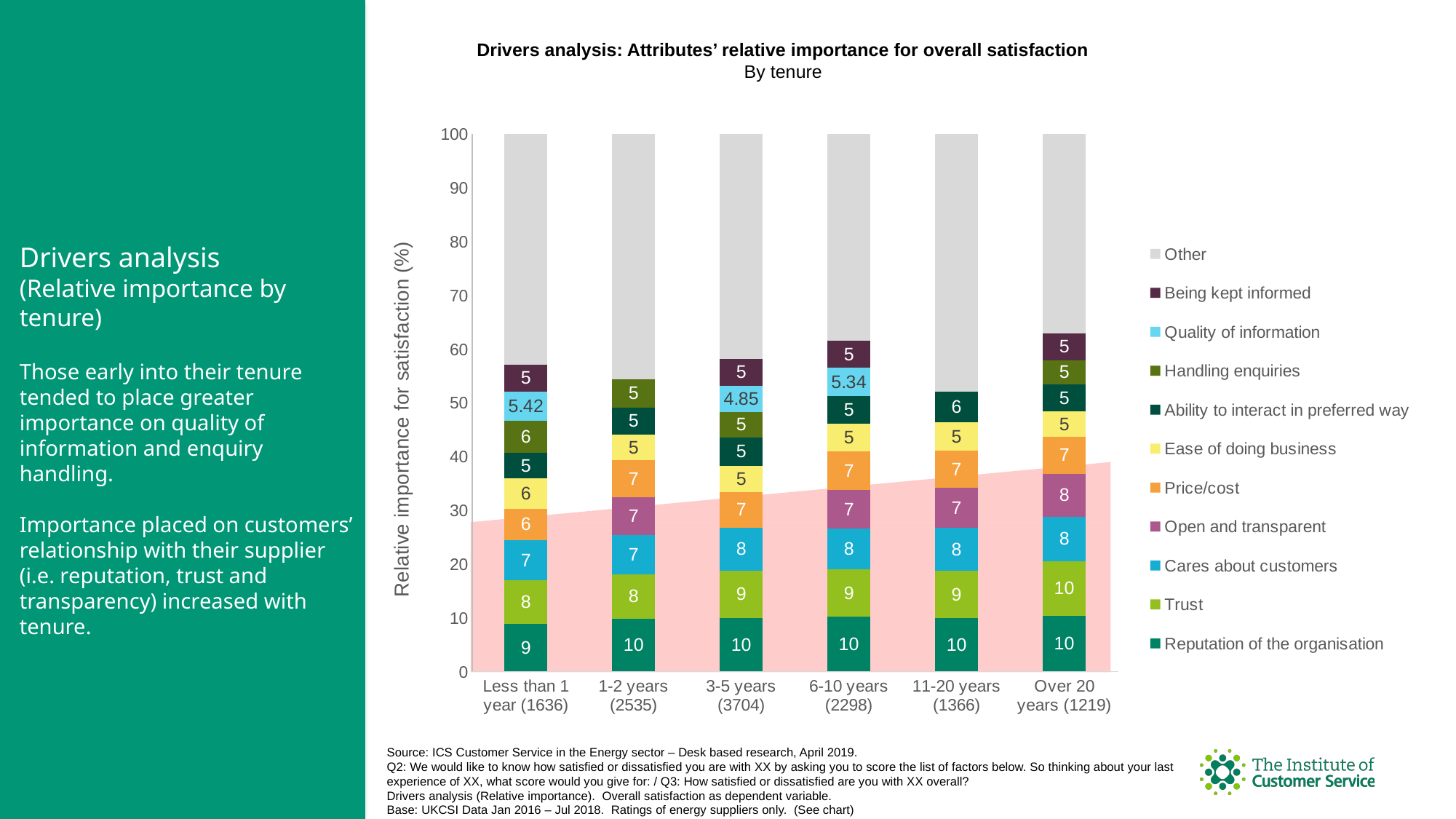
How many series does the legend list? 11 What is the value for Quality of information in the 6-10 years (2298) bar? 5.34 How many tenure categories are shown along the x axis? 6 Which tenure group has the lowest value for Reputation of the organisation? Less than 1 year (1636) What is the value for Reputation of the organisation in the Less than 1 year (1636) bar? 9 What is the value for Quality of information in the Less than 1 year (1636) bar? 5.42 Which is larger for Quality of information: the 6-10 years value or the 3-5 years value? 6-10 years What is the value for Ability to interact in preferred way in the 11-20 years (1366) bar? 6 What is the value for Open and transparent in the Over 20 years (1219) bar? 8 What is the value for Quality of information in the 3-5 years (3704) bar? 4.85 What kind of chart is shown on the slide? Stacked bar chart What is the difference between the Quality of information values for Less than 1 year and 3-5 years? 0.57